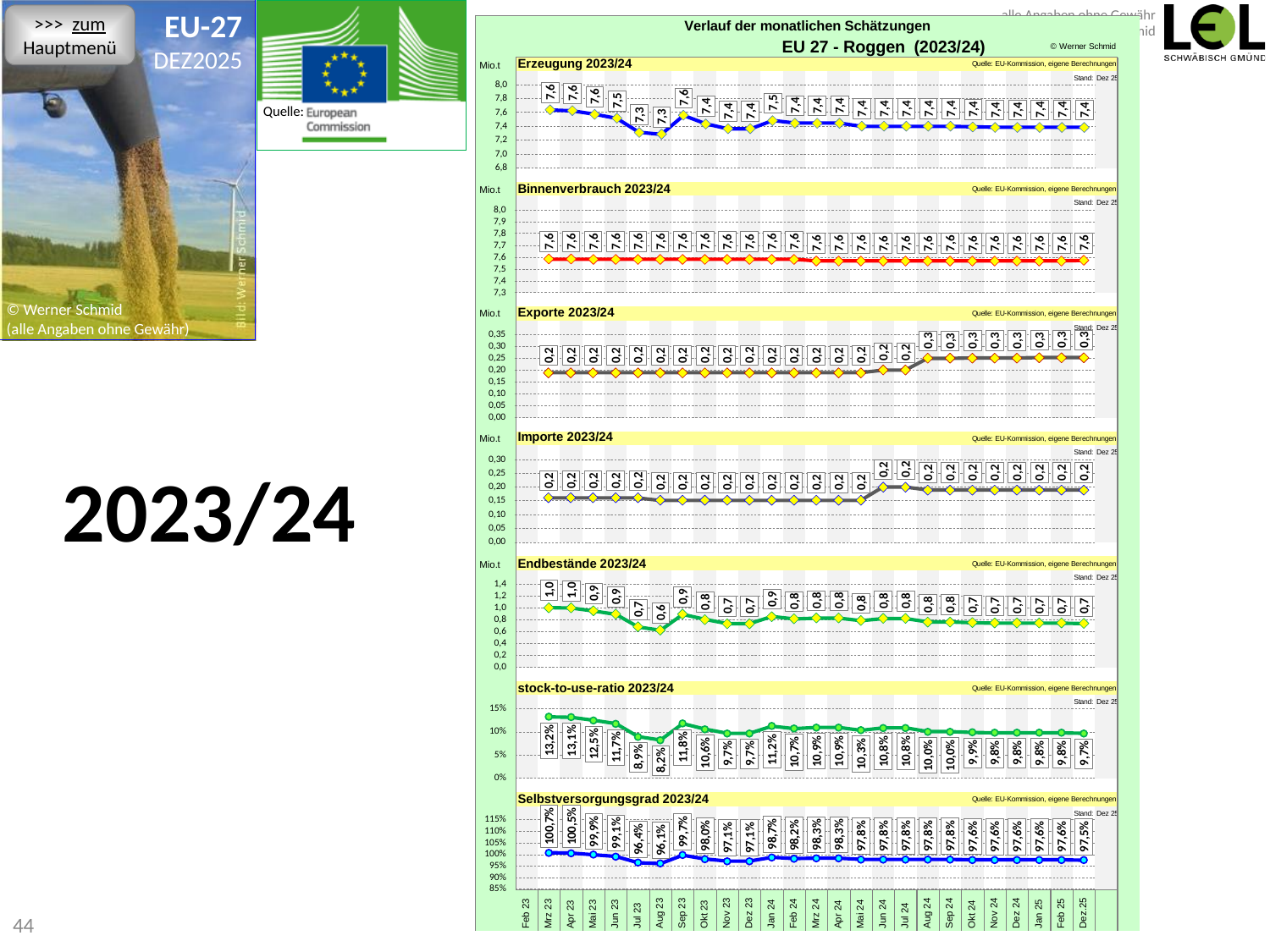
In the 'Endbestände 2023/24' chart, what is the lowest value shown? 0,6 In the 'stock-to-use-ratio 2023/24' chart, what is the lowest value shown? 8,2% In the 'Binnenverbrauch 2023/24' chart, do the values rise, fall or stay flat over time? stay flat In the 'Selbstversorgungsgrad 2023/24' chart, is the last data point greater or less than 100%? less In the 'Selbstversorgungsgrad 2023/24' chart, what is the lowest value shown? 96,1% In the 'stock-to-use-ratio 2023/24' chart, what is the difference between the highest and lowest values? 5,0 percentage points In the 'Selbstversorgungsgrad 2023/24' chart, what is the highest value shown? 100,7% How many separate charts are shown in the 'Verlauf der monatlichen Schätzungen' panel? 7 In the 'Selbstversorgungsgrad 2023/24' chart, what is the value of the last data point (Dez 25)? 97,5% What kind of chart is the 'Erzeugung 2023/24' chart? line chart In the 'stock-to-use-ratio 2023/24' chart, what is the highest value shown? 13,2% What is the main title of the chart panel on the right? EU 27 - Roggen (2023/24)